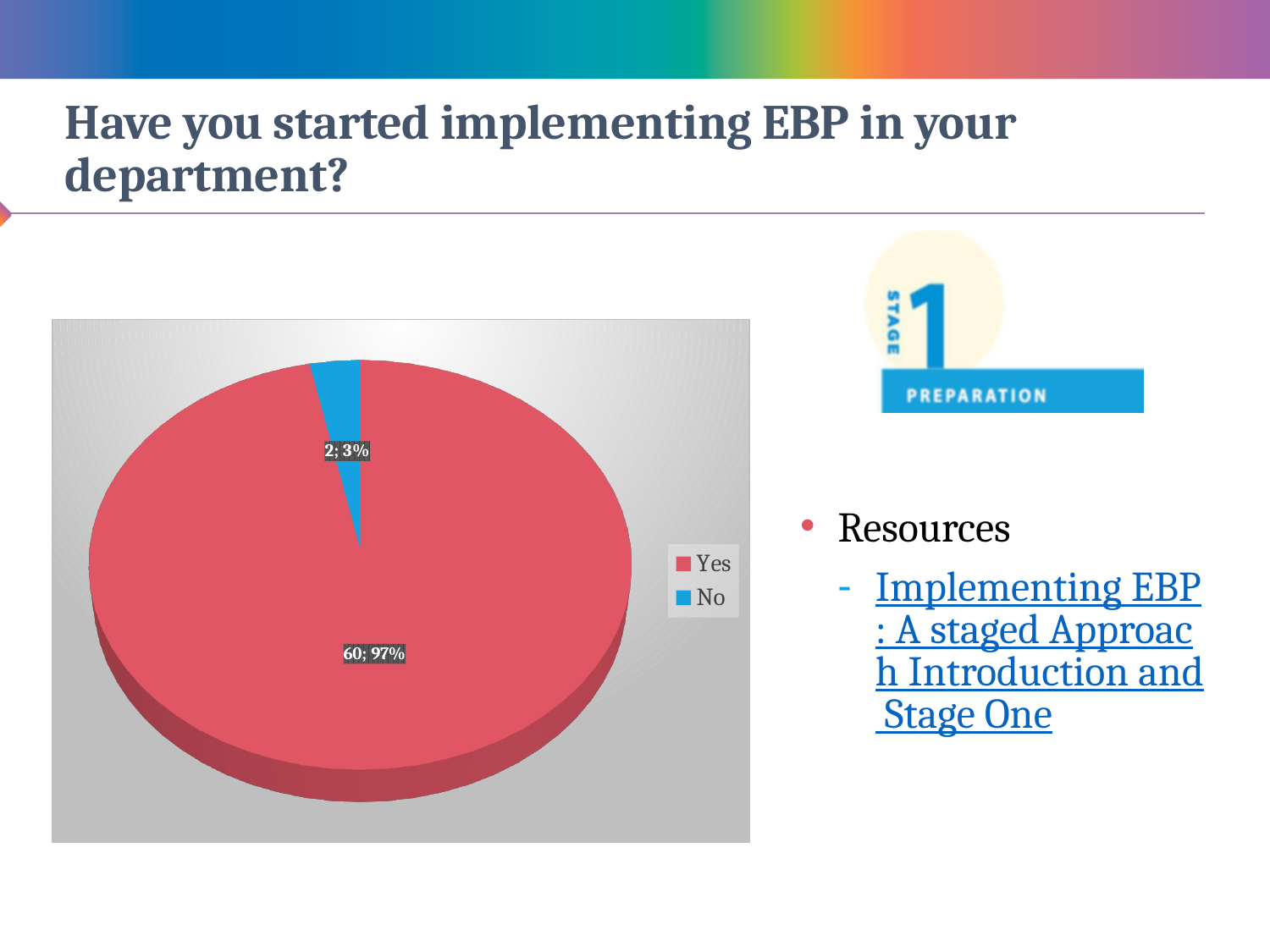
What share of the pie does the 'No' slice represent? 3% What is the difference between the 'Yes' count and the 'No' count in the pie chart? 58 How many entries does the legend of the pie chart list? 2 What is the count for the 'Yes' slice of the pie chart? 60 Which is larger in the pie chart, the 'Yes' slice or the 'No' slice? Yes What is the count for the 'No' slice of the pie chart? 2 How many categories does the pie chart show? 2 Which category has the largest slice in the pie chart? Yes Which category has the smallest slice in the pie chart? No What share of the pie does the 'Yes' slice represent? 97% What colour is the 'No' slice in the pie chart? blue What kind of chart is shown on the slide? pie chart